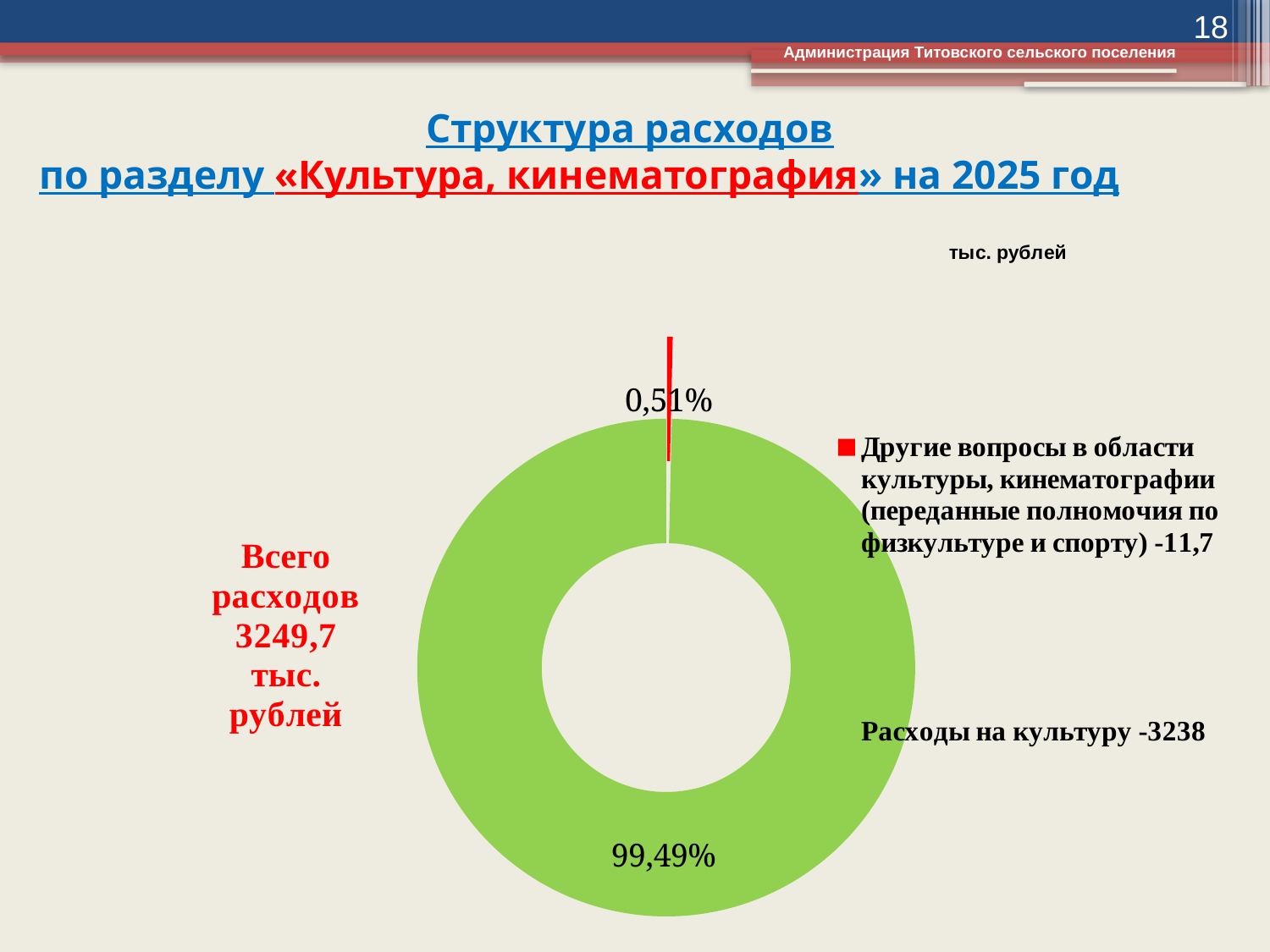
How many entries does the legend list? 2 Which category has the largest share of expenditures? Расходы на культуру What colour is the slice for Расходы на культуру? Green Which is larger: Расходы на культуру or Другие вопросы в области культуры, кинематографии? Расходы на культуру What value (тыс. рублей) is given in the legend for Другие вопросы в области культуры, кинематографии (переданные полномочия по физкультуре и спорту)? 11,7 How many slices does the chart have? 2 Which category has the smallest share of expenditures? Другие вопросы в области культуры, кинематографии (переданные полномочия по физкультуре и спорту) What percentage share is shown for the red slice (Другие вопросы в области культуры, кинематографии)? 0,51% What is the total of expenditures stated on the slide? 3249,7 тыс. рублей What percentage share is shown for the green slice (Расходы на культуру)? 99,49% What kind of chart is shown on the slide? Doughnut (pie) chart What value (тыс. рублей) is given in the legend for Расходы на культуру? 3238